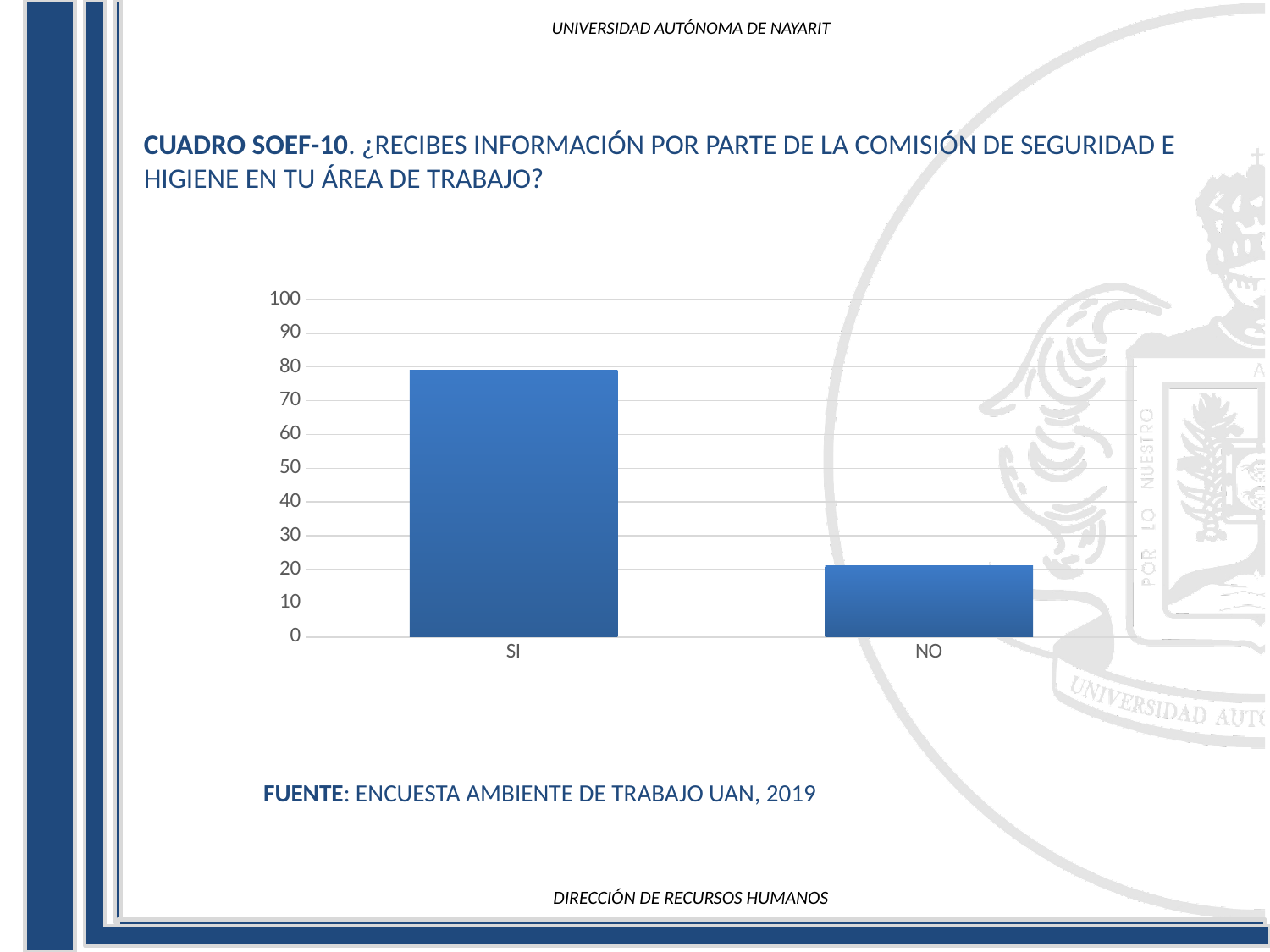
Is the value for NO greater or less than 10? greater How many categories are shown on the x axis of the chart? 2 Is the value for SI greater or less than 50? greater Which category has the lowest bar in the chart? NO Which is larger, the value for SI or the value for NO? SI What kind of chart is shown on the slide? bar chart What is the highest value shown on the y axis of the chart? 100 Is the value for SI greater or less than 90? less Which category has the highest bar in the chart? SI What is the cuadro number given in the title above the chart? CUADRO SOEF-10